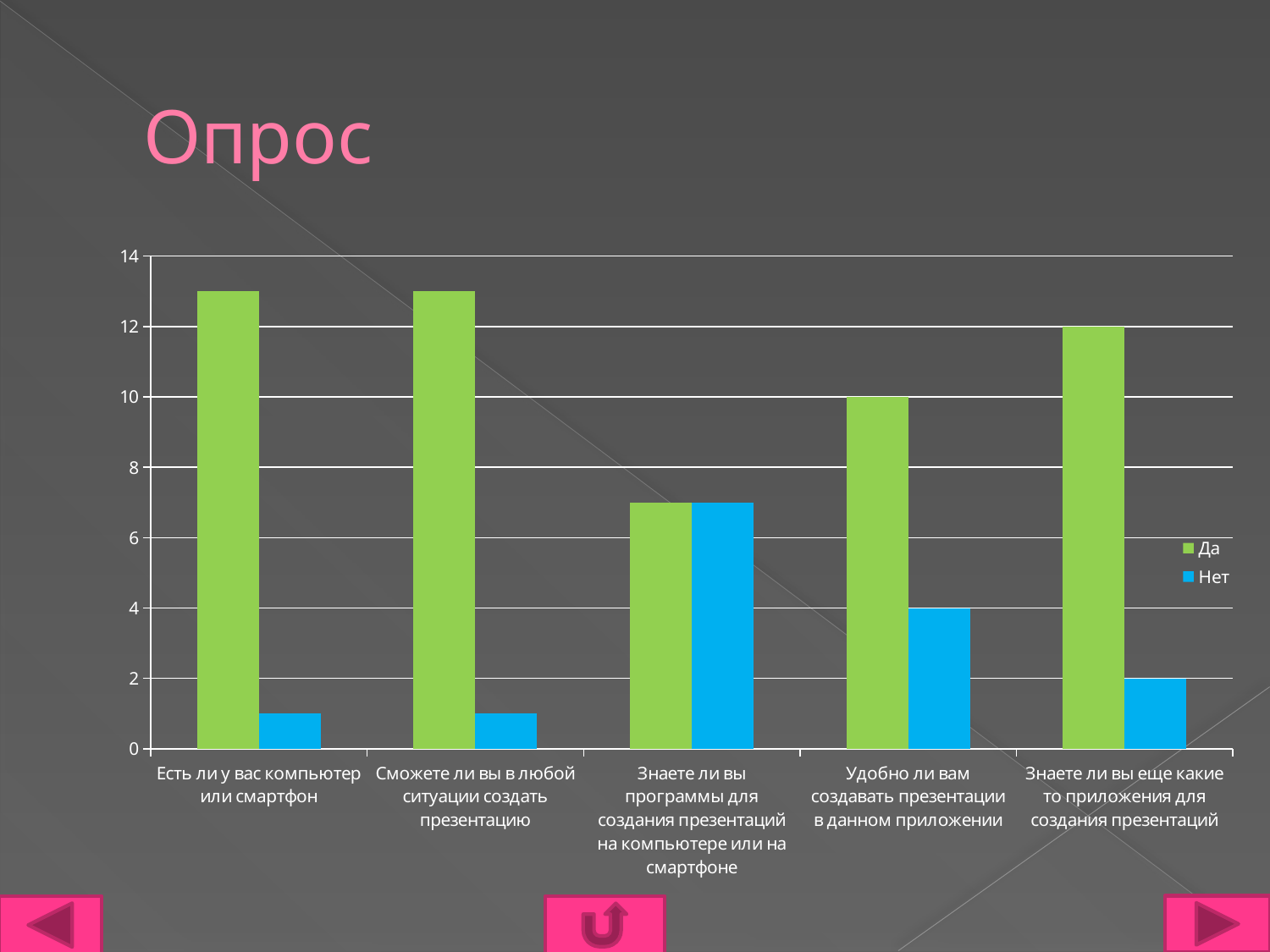
What is the title of the slide containing the chart? Опрос What is the value of "Нет" for "Удобно ли вам создавать презентации в данном приложении"? 4 What type of chart is shown on the slide? bar chart What is the value of "Да" for "Знаете ли вы еще какие то приложения для создания презентаций"? 12 What is the difference between the "Да" values for "Знаете ли вы еще какие то приложения для создания презентаций" and "Удобно ли вам создавать презентации в данном приложении"? 2 Is the "Да" value for "Есть ли у вас компьютер или смартфон" greater or less than 12? greater For which question is the "Нет" value highest? Знаете ли вы программы для создания презентаций на компьютере или на смартфоне How many question categories are shown on the x axis? 5 How many series does the legend list? 2 What is the value of "Да" for "Удобно ли вам создавать презентации в данном приложении"? 10 What is the value of "Нет" for "Знаете ли вы еще какие то приложения для создания презентаций"? 2 For which question is the "Да" value lowest? Знаете ли вы программы для создания презентаций на компьютере или на смартфоне